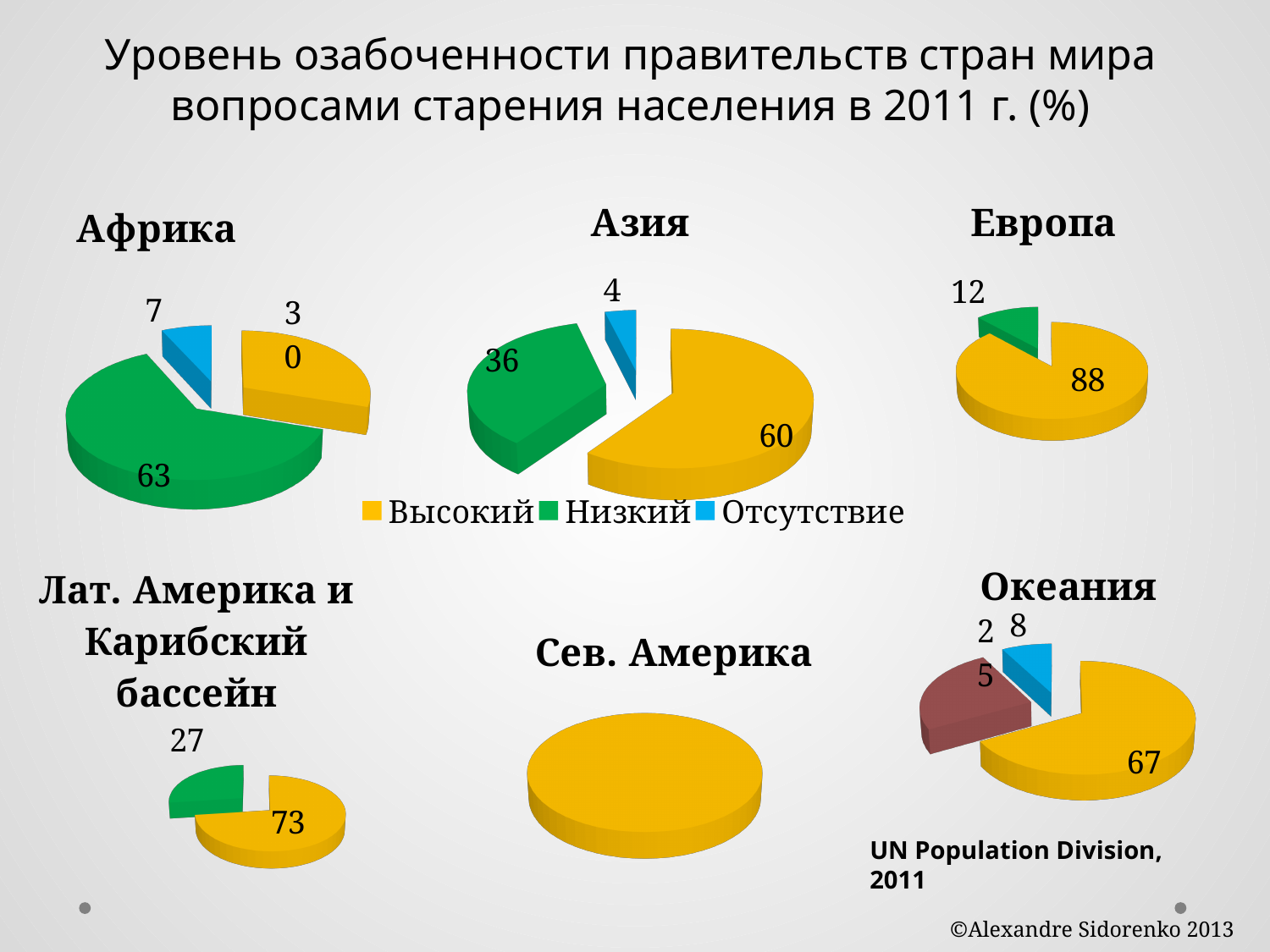
How many pie charts are shown on the slide? 6 What kind of chart is the Европа chart? Pie chart In the Лат. Америка и Карибский бассейн chart, what is the value for Высокий? 73 In the Европа chart, what is the difference between Высокий and Низкий? 76 In the Европа chart, what is the value for Низкий? 12 How many entries does the shared legend list? 3 In the Океания chart, what is the value for Отсутствие? 8 In the Азия chart, what is the value for Высокий? 60 In the Азия chart, which is larger, Высокий or Низкий? Высокий In the Африка chart, which category has the largest slice? Низкий In the Азия chart, what is the value for Отсутствие? 4 In the Африка chart, what is the value for Низкий? 63